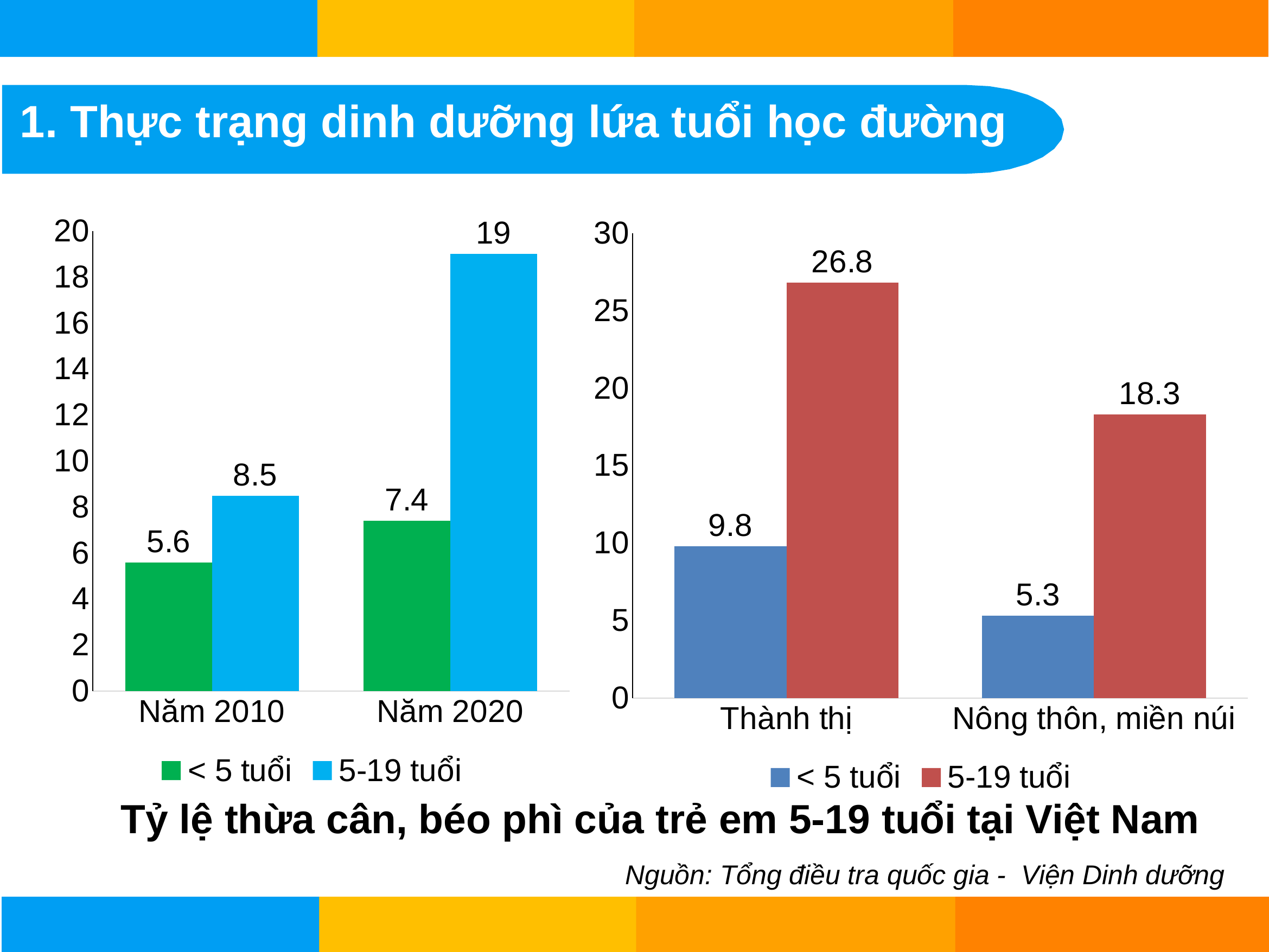
In the left chart, which category has the lowest value for < 5 tuổi? Năm 2010 In the left chart, what is the value for 5-19 tuổi in Năm 2020? 19 What kind of chart is the left chart? bar chart In the left chart, does the value for 5-19 tuổi rise or fall from Năm 2010 to Năm 2020? rise In the right chart, what is the difference between the 5-19 tuổi values for Thành thị and Nông thôn, miền núi? 8.5 In the left chart, what is the value for < 5 tuổi in Năm 2010? 5.6 In the right chart, what is the value for 5-19 tuổi in Thành thị? 26.8 In the right chart, which is larger: < 5 tuổi in Thành thị or < 5 tuổi in Nông thôn, miền núi? Thành thị In the left chart, what is the difference between the 5-19 tuổi values for Năm 2020 and Năm 2010? 10.5 In the right chart, which category has the highest value for 5-19 tuổi? Thành thị In the right chart, what is the value for < 5 tuổi in Nông thôn, miền núi? 5.3 How many series does the legend of the right chart list? 2